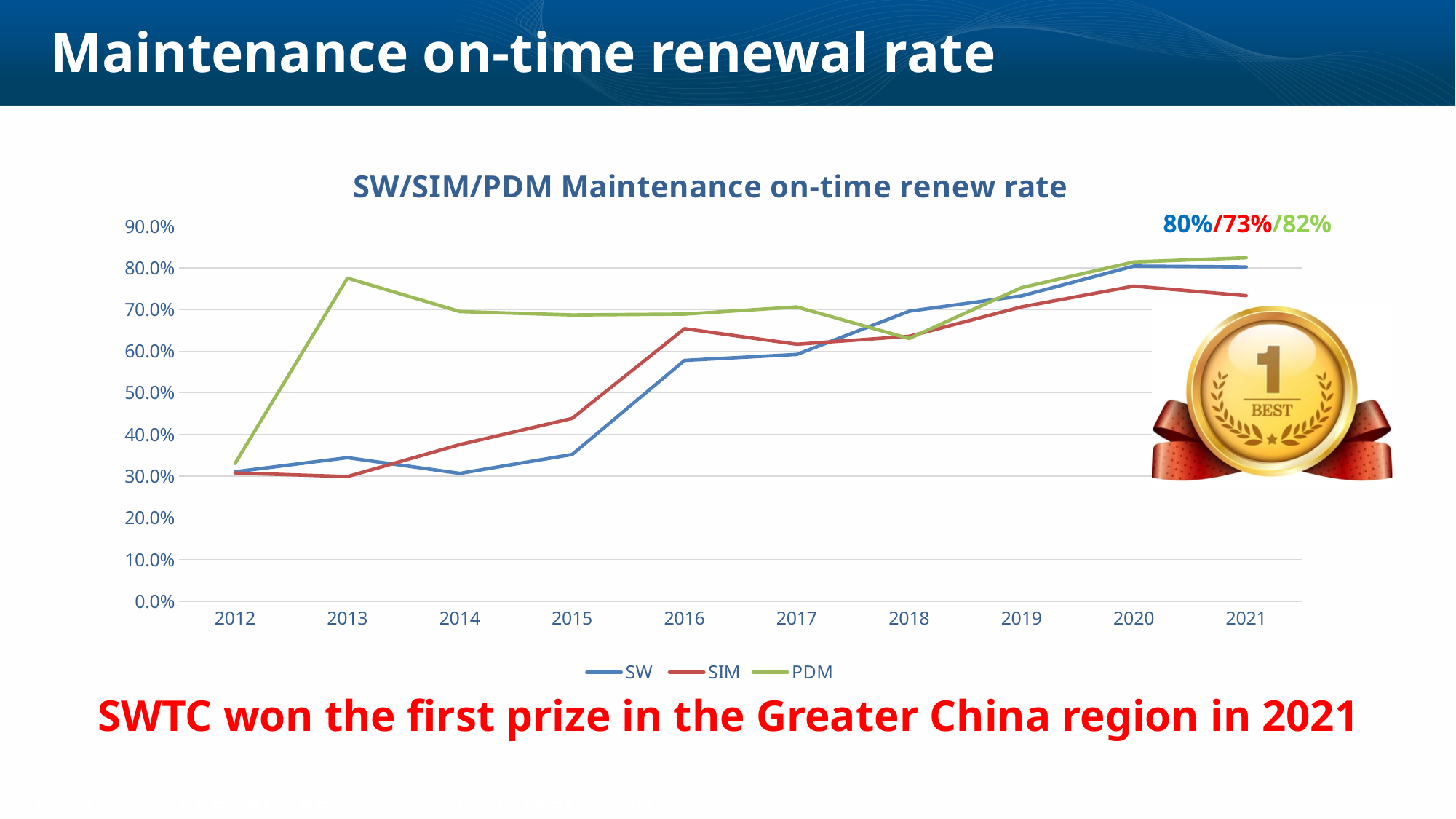
Is the PDM value for 2013 greater or less than 70.0%? greater What is the SIM maintenance on-time renew rate in 2021? 73% How many series does the legend list? 3 What kind of chart is shown on the slide? line chart What is the SW maintenance on-time renew rate in 2021? 80% Which series has the highest value in 2021? PDM What is the difference between the PDM and SIM rates in 2021? 9% Does the SW line generally rise or fall from 2012 to 2021? rise How many years are shown on the x axis? 10 In 2016, which is larger, the SIM value or the SW value? SIM Which series has the lowest value in 2021? SIM What is the PDM maintenance on-time renew rate in 2021? 82%